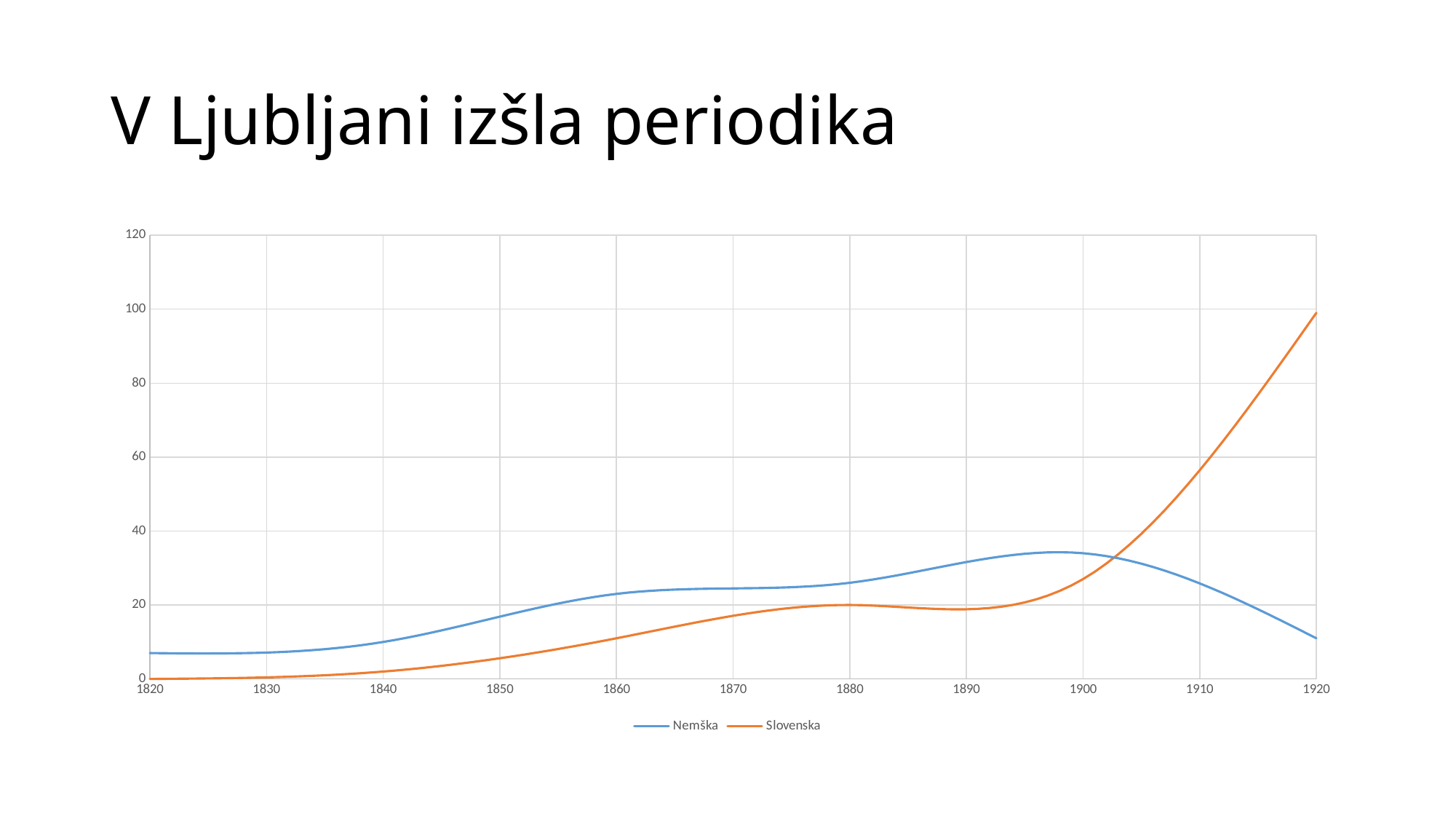
Is the value for Slovenska in 1850 greater or less than 20? less Which series has the higher value in 1860, Nemška or Slovenska? Nemška Is the value for Slovenska in 1910 greater or less than 40? greater What kind of chart is shown on the slide? line chart What is the title of the slide? V Ljubljani izšla periodika Does the Nemška line rise or fall between 1900 and 1920? fall Is the value for Slovenska in 1920 greater or less than 80? greater How many series does the legend list? 2 Which series has the higher value in 1920, Nemška or Slovenska? Slovenska Which series is drawn in orange? Slovenska How many years are labelled on the x axis? 11